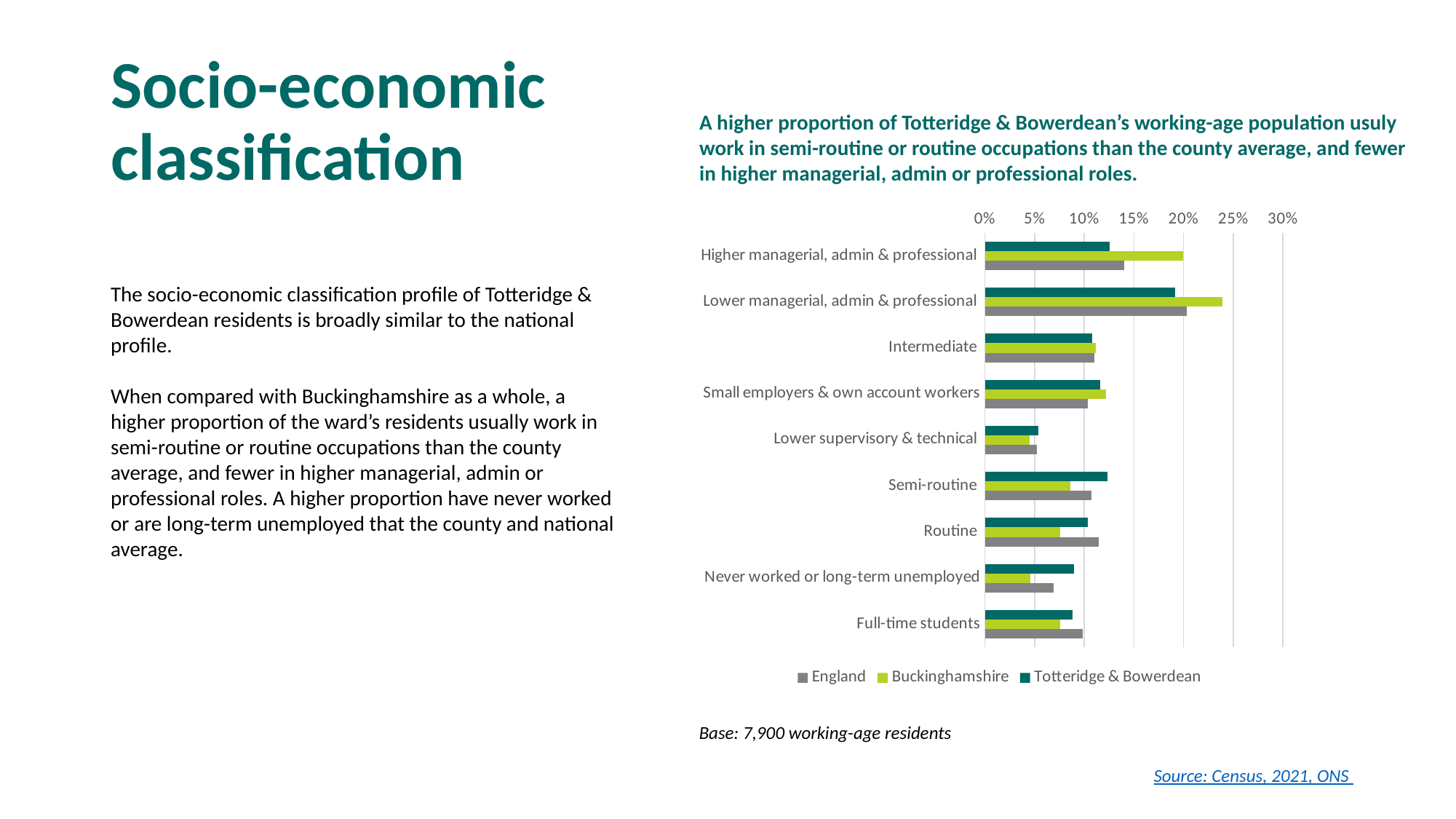
What kind of chart is shown on the slide? Bar chart Which category has the highest value for Totteridge & Bowerdean? Lower managerial, admin & professional How many socio-economic categories are plotted on the chart? 9 Is the Buckinghamshire value for Higher managerial, admin & professional greater or less than 15%? greater How many series does the chart legend list? 3 For Higher managerial, admin & professional, which is larger: Buckinghamshire or Totteridge & Bowerdean? Buckinghamshire Is the Buckinghamshire value for Lower managerial, admin & professional greater or less than 20%? greater Which colour represents England in the chart legend? Grey Which category has the lowest value for Totteridge & Bowerdean? Lower supervisory & technical Which category has the highest value for Buckinghamshire? Lower managerial, admin & professional Is the Totteridge & Bowerdean value for Never worked or long-term unemployed greater or less than 5%? greater For Semi-routine, which is larger: Totteridge & Bowerdean or Buckinghamshire? Totteridge & Bowerdean